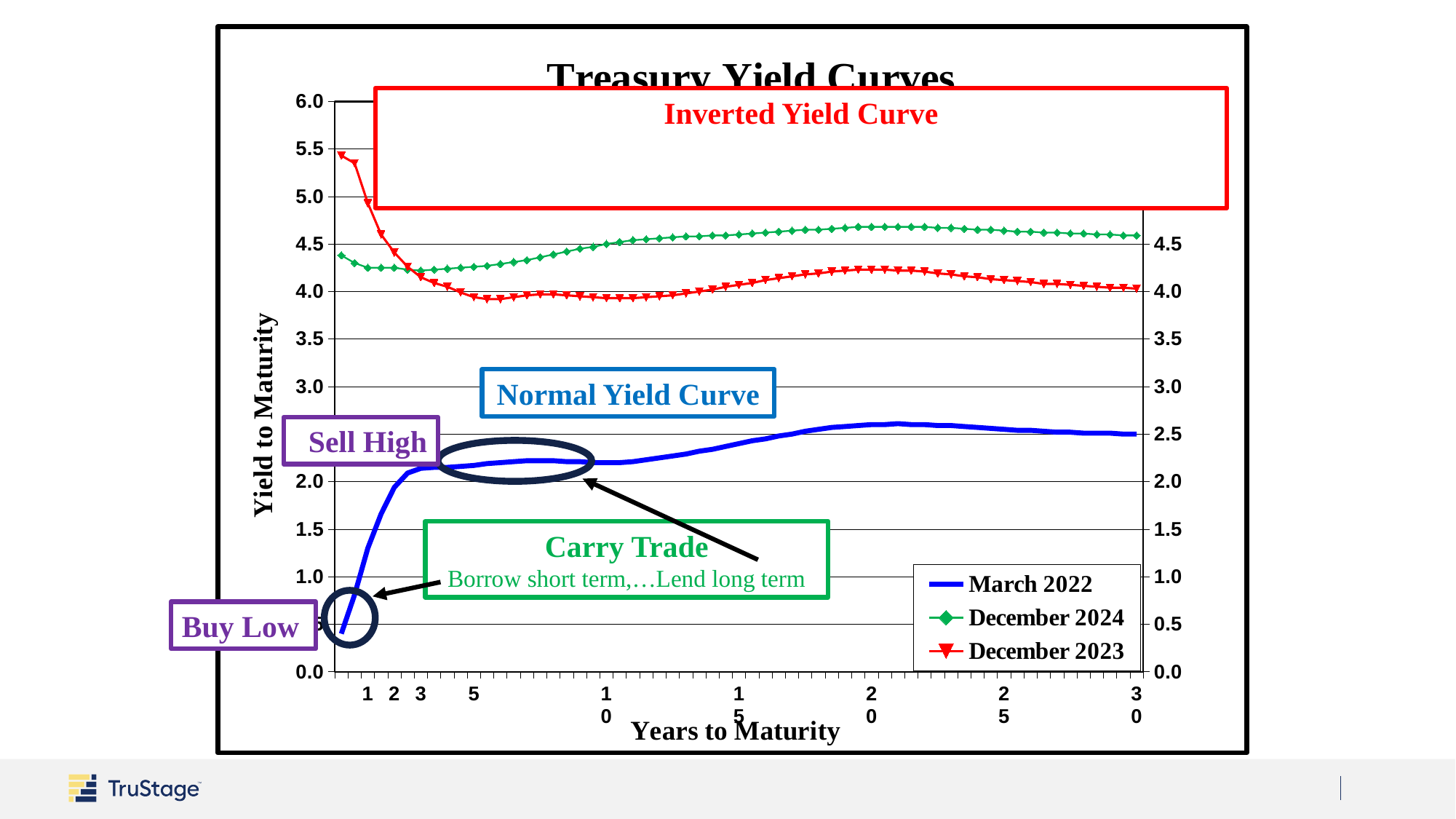
Is the December 2023 value at 5 years to maturity greater or less than 4.5? less Is the March 2022 value at 1 year to maturity greater or less than 1.5? less What is the label of the x axis? Years to Maturity At 1 year to maturity, which series is higher: December 2023 or December 2024? December 2023 How many series does the legend list? 3 Which series has the lowest yields across the whole range of maturities? March 2022 What kind of chart is shown on the slide? Line chart Is the March 2022 value at 10 years to maturity greater or less than 2.0? greater Does the December 2023 curve rise or fall between 1 and 5 years to maturity? Fall At 30 years to maturity, which series is higher: December 2023 or December 2024? December 2024 What is the title of the chart? Treasury Yield Curves